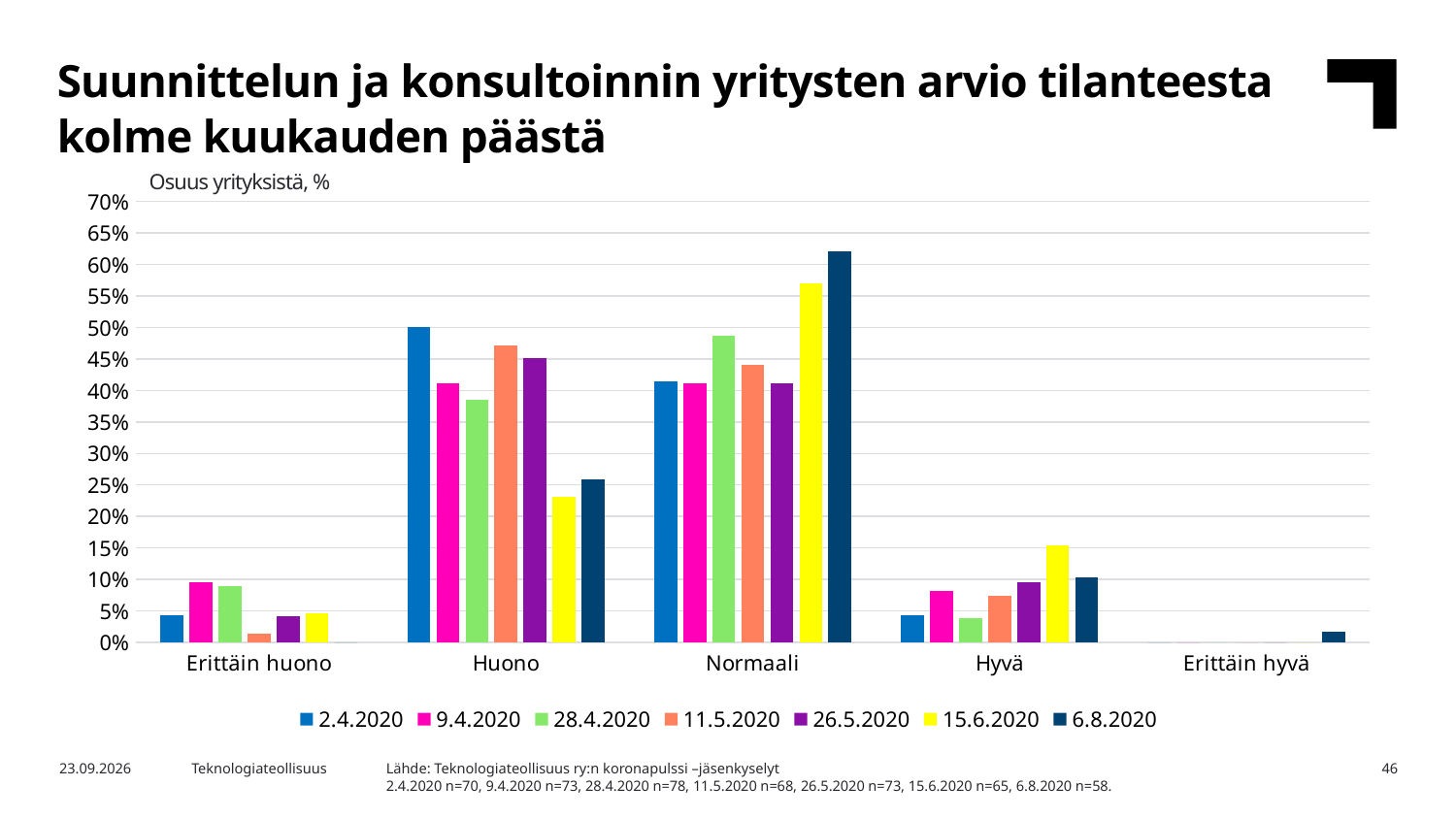
Is the value for Huono in the 2.4.2020 series greater or less than 45%? greater How many categories are shown on the x axis? 5 Is the value for Huono in the 15.6.2020 series greater or less than 30%? less What is the label shown above the y axis? Osuus yrityksistä, % Within the Hyvä category, which series has the highest value? 15.6.2020 For the Hyvä category, which is larger: the 15.6.2020 value or the 6.8.2020 value? 15.6.2020 How many series does the legend list? 7 For the 2.4.2020 series, which category has the lowest value? Erittäin hyvä What kind of chart is shown on the slide? bar chart For the 6.8.2020 series, which category has the highest value? Normaali In the 15.6.2020 series, which is larger: Normaali or Huono? Normaali Is the value for Normaali in the 6.8.2020 series greater or less than 60%? greater